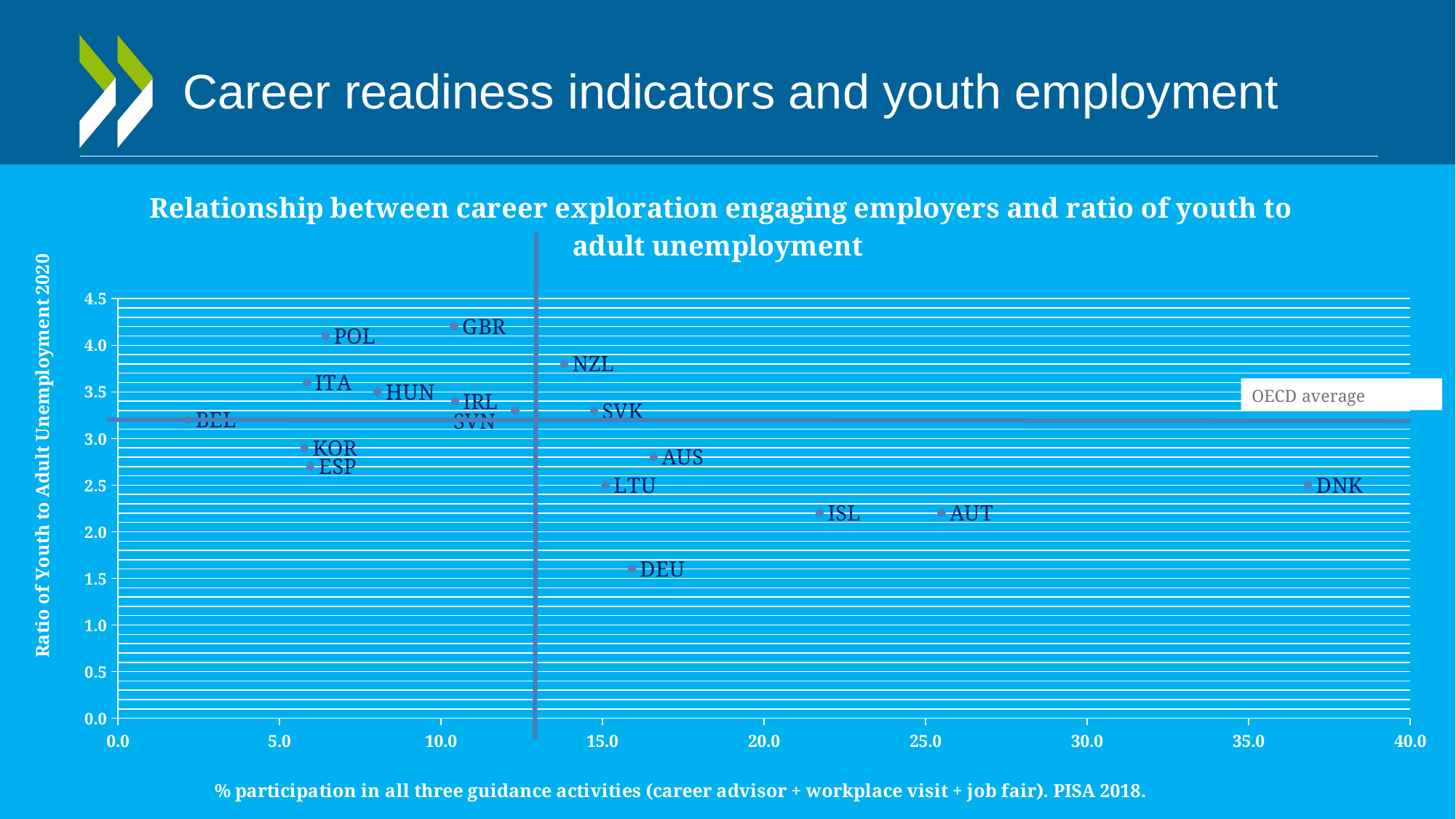
Which country has the lowest % participation in all three guidance activities? BEL Which country has the highest ratio of youth to adult unemployment? GBR How many countries are plotted on the chart? 17 Is the ratio of youth to adult unemployment for DEU greater or less than 2.0? less Is the % participation for BEL greater or less than 5.0? less Which country has the highest % participation in all three guidance activities? DNK What kind of chart is shown on the slide? scatter chart Which has a higher ratio of youth to adult unemployment, NZL or AUS? NZL What is the label on the x axis of the chart? % participation in all three guidance activities (career advisor + workplace visit + job fair). PISA 2018. Is the % participation for DNK greater or less than 35.0? greater Which country has the lowest ratio of youth to adult unemployment? DEU